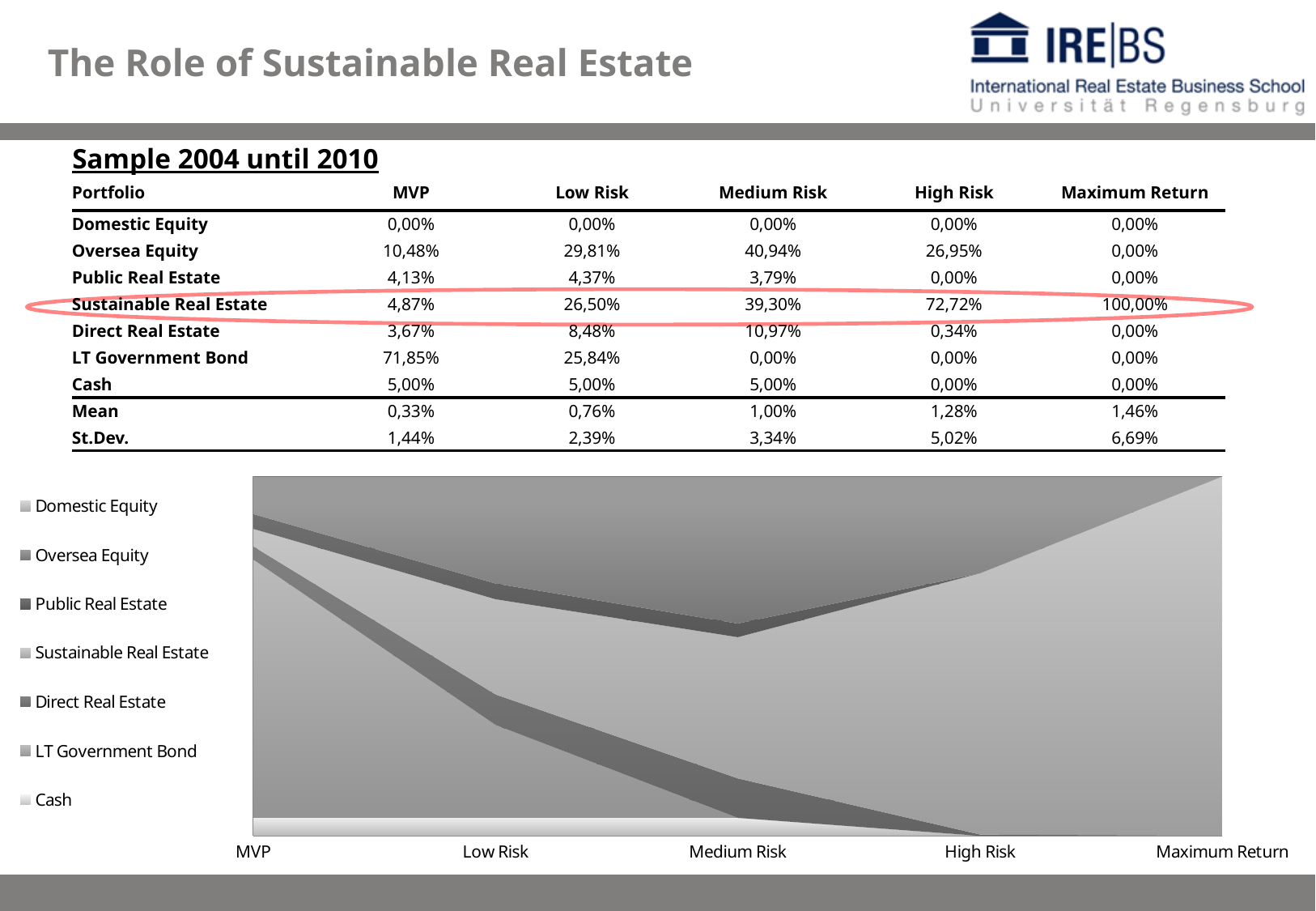
What is the heading printed above the table and chart? Sample 2004 until 2010 What is the share of LT Government Bond in the MVP portfolio? 71,85% What kind of chart is shown at the bottom of the slide? area chart What is the share of Oversea Equity in the Medium Risk portfolio? 40,94% How many portfolio categories are shown along the x axis of the chart? 5 How many series does the chart's legend list? 7 Which series has the largest share in the MVP portfolio? LT Government Bond What is the share of Sustainable Real Estate in the Maximum Return portfolio? 100,00% In the Low Risk portfolio, which is larger: the share of Oversea Equity or the share of Sustainable Real Estate? Oversea Equity Does the share of LT Government Bond rise or fall from MVP to Maximum Return along the x axis? fall What is the difference between the Sustainable Real Estate share in the High Risk portfolio and in the Medium Risk portfolio? 33,42% In which portfolio is the share of Sustainable Real Estate highest? Maximum Return